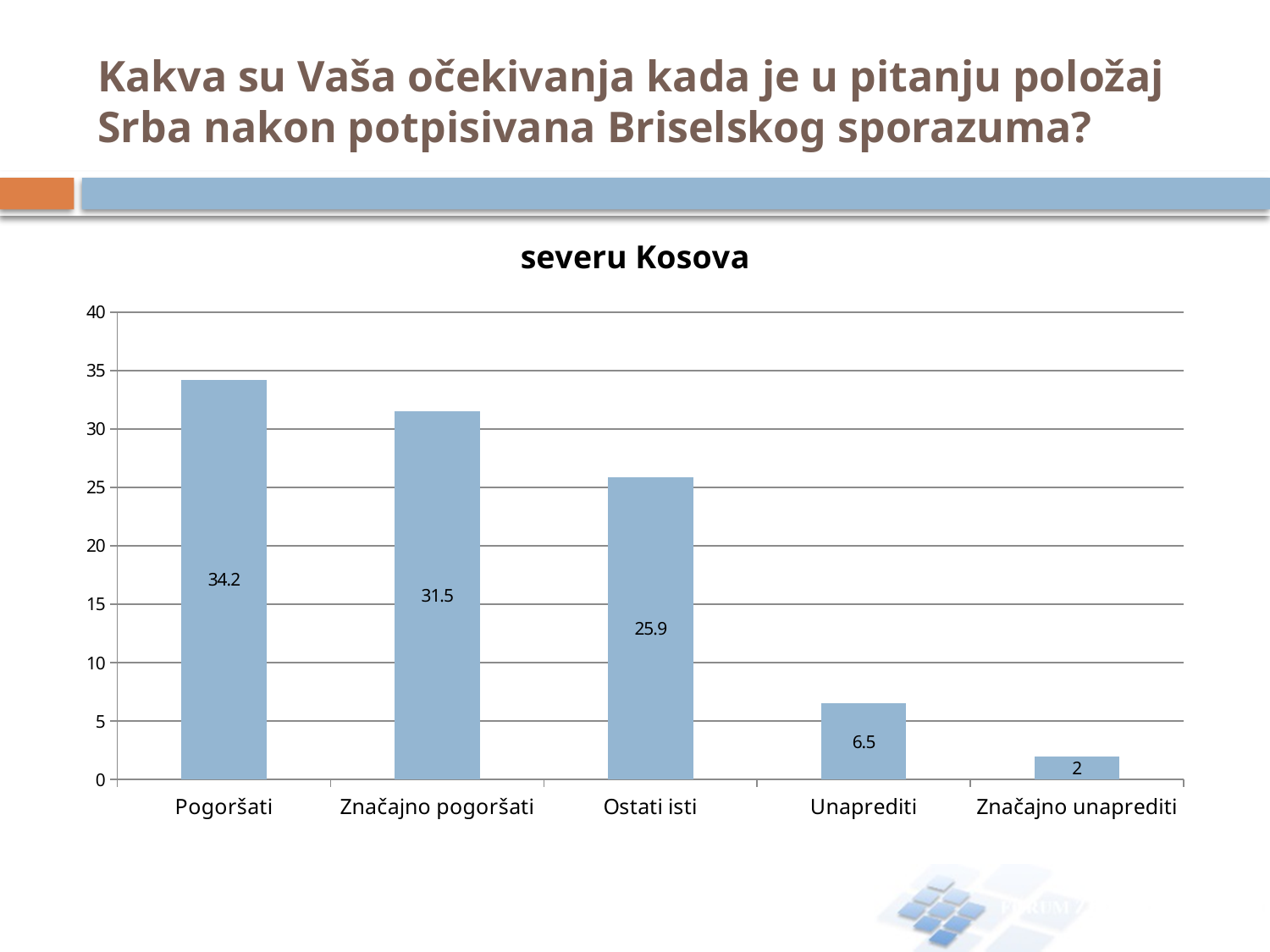
What kind of chart is shown on the slide? Bar chart What is the value for Pogoršati? 34.2 How many categories are shown on the x axis? 5 What is the value for Značajno unaprediti? 2 What is the value for Značajno pogoršati? 31.5 Which category has the highest value? Pogoršati What is the difference between the values for Pogoršati and Ostati isti? 8.3 What is the value for Unaprediti? 6.5 Which is larger, the value for Unaprediti or the value for Značajno unaprediti? Unaprediti What is the value for Ostati isti? 25.9 Which category has the lowest value? Značajno unaprediti What is the title of the chart? severu Kosova